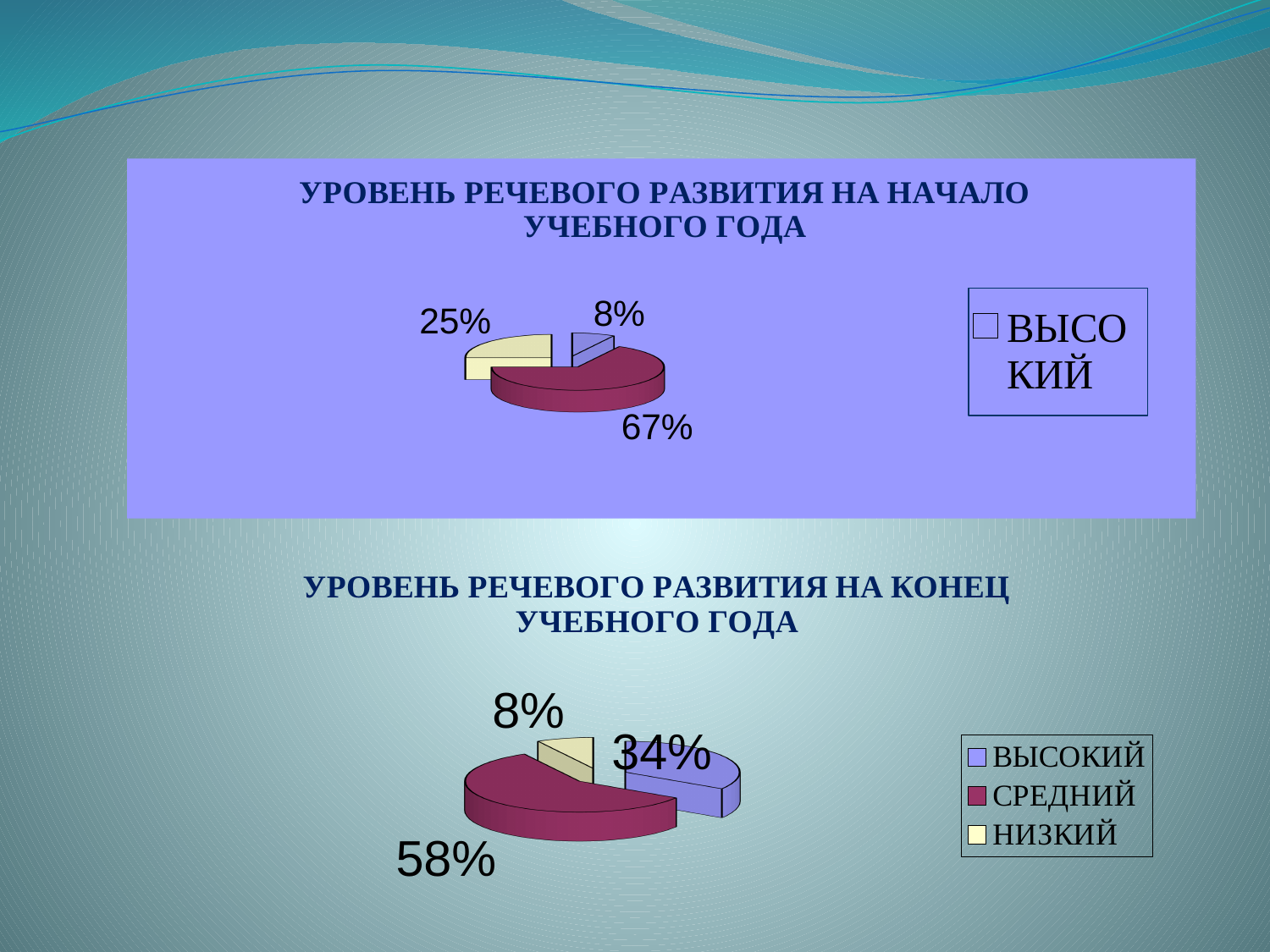
In the bottom chart (end of the school year), which category has the smallest share? НИЗКИЙ In the top chart (start of the school year), what is the value of the largest slice? 67% In the top chart (start of the school year), what is the value of the yellow slice? 25% What kind of chart is shown under the title 'УРОВЕНЬ РЕЧЕВОГО РАЗВИТИЯ НА КОНЕЦ УЧЕБНОГО ГОДА'? pie chart In the top chart (start of the school year), what is the value of the smallest slice? 8% How many entries does the legend of the bottom chart (end of the school year) list? 3 In the bottom chart (end of the school year), what is the value for ВЫСОКИЙ? 34% In the bottom chart (end of the school year), which category has the largest share? СРЕДНИЙ In the bottom chart (end of the school year), what is the value for НИЗКИЙ? 8% In the bottom chart (end of the school year), what is the difference between the СРЕДНИЙ and ВЫСОКИЙ shares? 24% How many slices does the top chart (start of the school year) have? 3 In the bottom chart (end of the school year), what is the value for СРЕДНИЙ? 58%